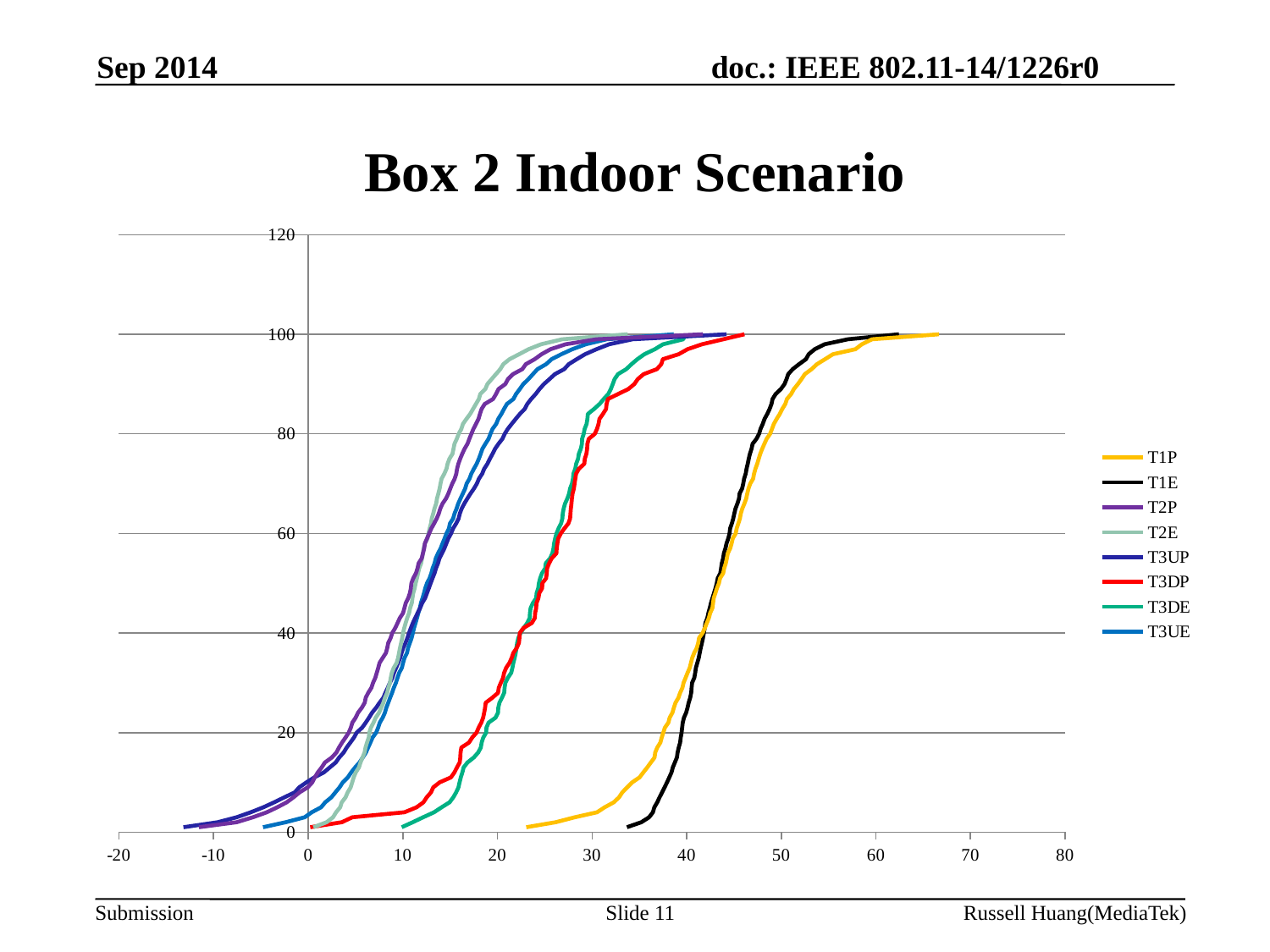
At x = 20, which series has the larger value, T3UP or T3DP? T3UP How many series does the legend list? 8 Which series is drawn in red in the legend? T3DP Do the values of the T1P series rise or fall as x increases? rise What kind of chart is shown on the slide? line chart Is the value of the T2E series at x = 0 greater or less than 20? less What is the title of the chart? Box 2 Indoor Scenario At x = 40, which series has the larger value, T1P or T1E? T1P Is the value of the T3DP series at x = 30 greater or less than 60? greater Is the value of the T1P series at x = 40 greater or less than 40? less